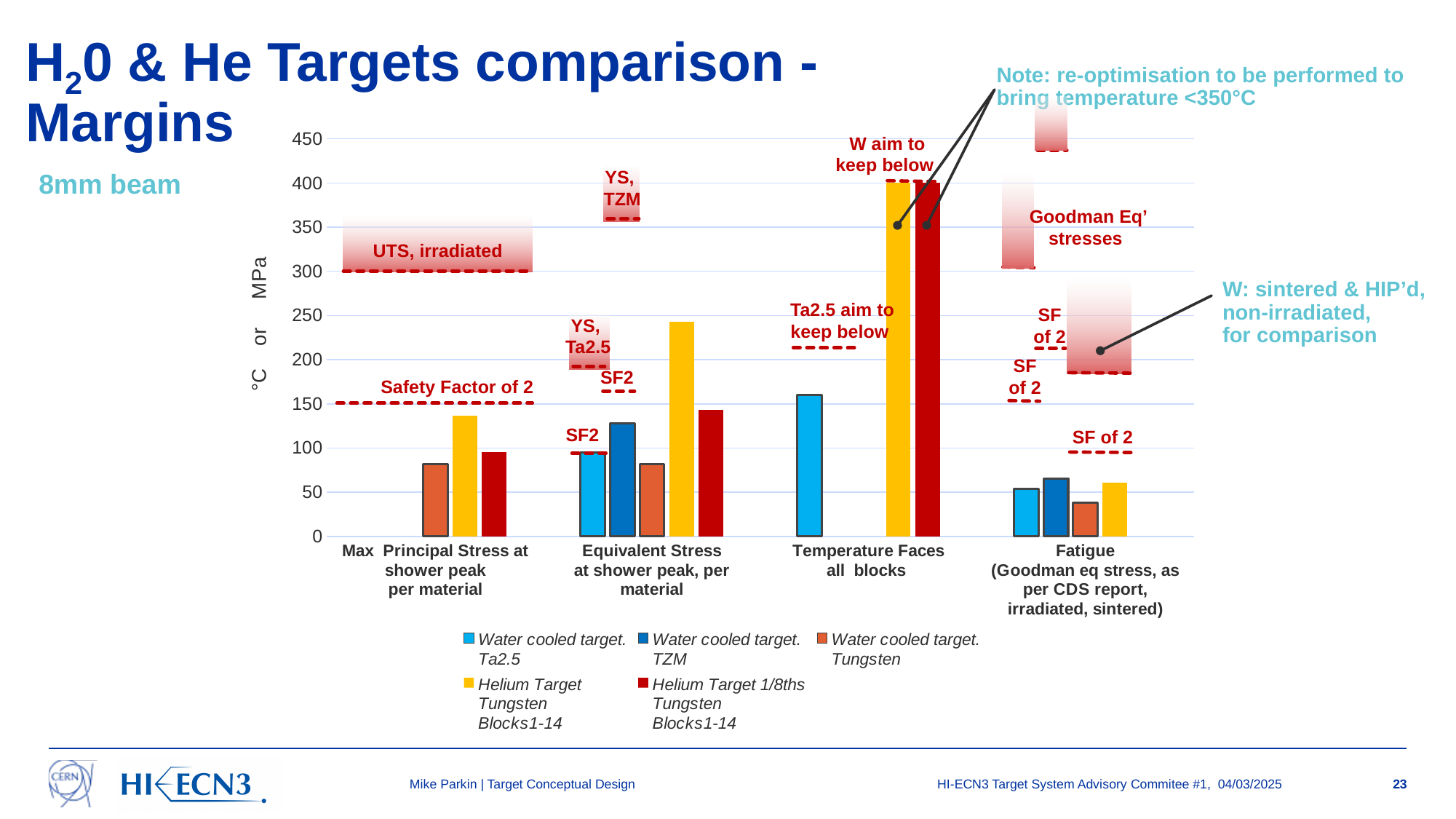
In the Max Principal Stress at shower peak category, which series has the highest bar? Helium Target Tungsten Blocks1-14 Is the value for Helium Target Tungsten Blocks1-14 in the Max Principal Stress at shower peak category greater or less than 150? less In the Equivalent Stress at shower peak category, which is larger: Water cooled target TZM or Water cooled target Tungsten? Water cooled target. TZM In the Equivalent Stress at shower peak category, which series has the highest bar? Helium Target Tungsten Blocks1-14 Is the value for Helium Target Tungsten Blocks1-14 in the Temperature Faces all blocks category greater or less than 350? greater Is the value for Helium Target Tungsten Blocks1-14 in the Equivalent Stress at shower peak category greater or less than 200? greater How many series does the legend list? 5 What is the label on the vertical axis of the chart? °C or MPa In the Fatigue category, which series has the lowest bar? Water cooled target. Tungsten What kind of chart is shown on the slide? bar chart How many categories are shown along the x axis? 4